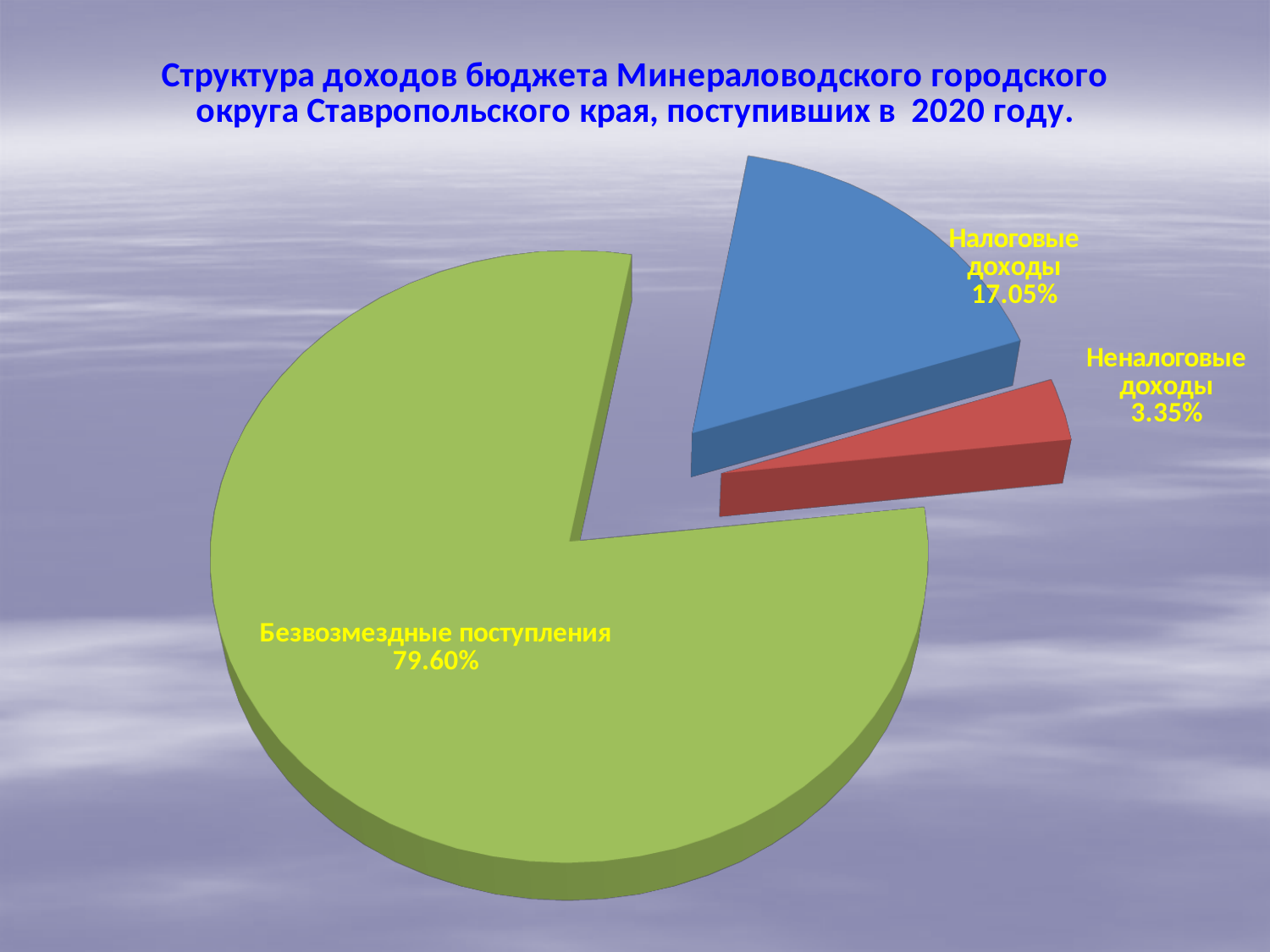
What share of the pie does Налоговые доходы have? 17.05% What year does the chart title say the budget revenues were received in? 2020 What share of the pie does Неналоговые доходы have? 3.35% Which is larger, Налоговые доходы or Неналоговые доходы? Налоговые доходы Which category has the smallest slice of the pie? Неналоговые доходы What is the difference in percentage points between Налоговые доходы and Неналоговые доходы? 13.70 How many slices does the pie chart have? 3 What is the difference in percentage points between Безвозмездные поступления and Налоговые доходы? 62.55 What share of the pie does Безвозмездные поступления have? 79.60% What kind of chart is shown on the slide? pie chart Which category has the largest slice of the pie? Безвозмездные поступления What colour is the slice for Налоговые доходы? blue